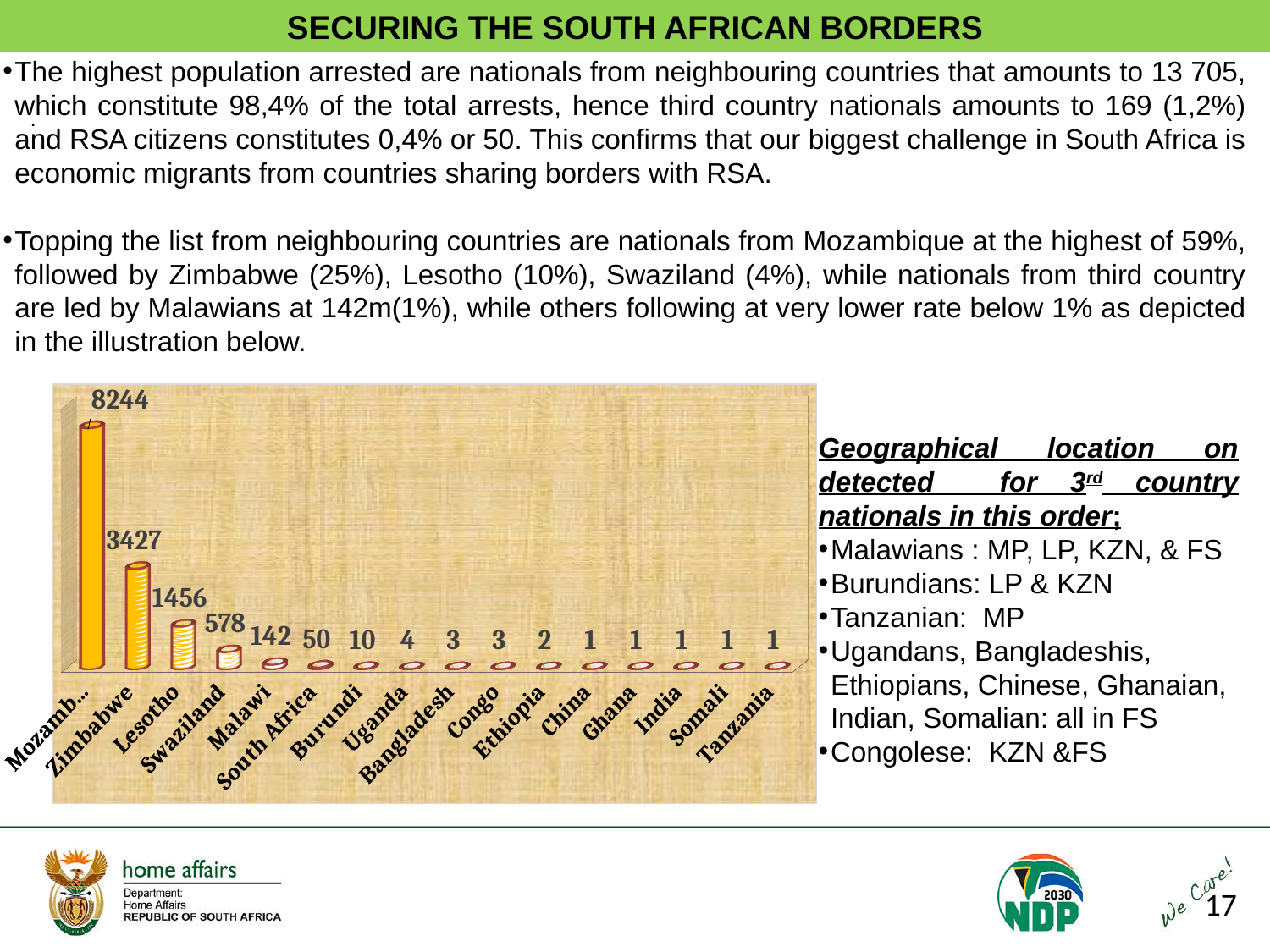
Which has a larger value, Uganda or Burundi? Burundi What kind of chart is shown on the slide? Bar chart What value is shown for Burundi in the chart? 10 Do the values rise or fall moving from left to right along the x axis? Fall Which category has the highest value in the chart? Mozambique What value is shown for Zimbabwe in the chart? 3427 What is the difference between the values for Zimbabwe and Lesotho? 1971 What is the difference between the values for Swaziland and Malawi? 436 What value is shown for Lesotho in the chart? 1456 What value is shown for South Africa in the chart? 50 How many categories are shown on the x axis of the chart? 16 What value is shown for Malawi in the chart? 142